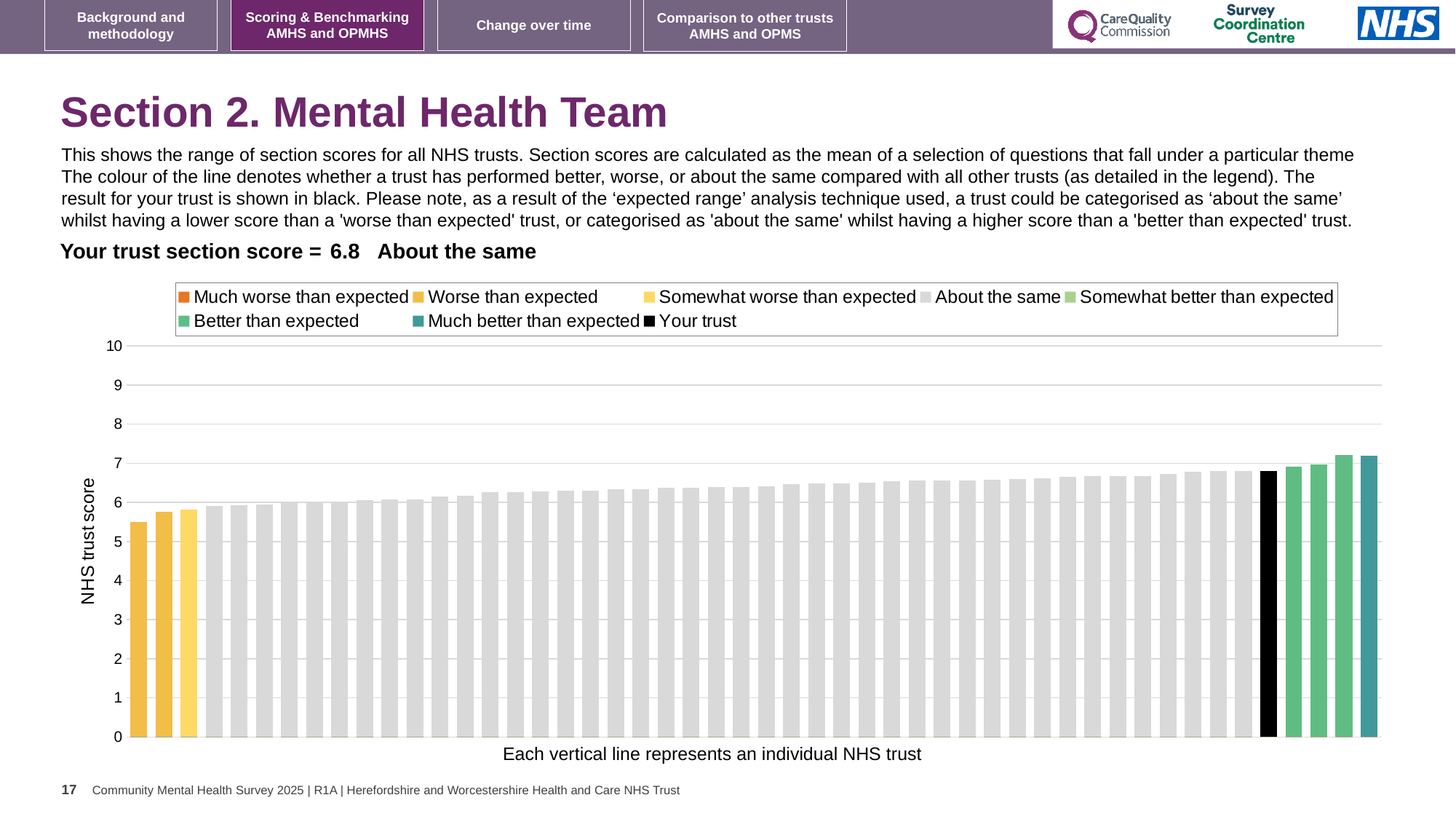
Which category is your trust placed in according to the slide? About the same What kind of chart is shown on the slide? bar chart How many bars are coloured teal (Much better than expected)? 1 What colour is the bar representing your trust? black Is the value of the lowest bar in the chart greater or less than 6? less How many entries does the chart legend list? 8 What is the section score for your trust shown on the slide? 6.8 Is the value for your trust (the black bar) greater or less than 6? greater Do the bar values rise or fall from left to right along the x axis? rise What is the highest value shown on the vertical axis? 10 Is the value of the highest bar in the chart greater or less than 8? less What is the label on the vertical axis of the chart? NHS trust score